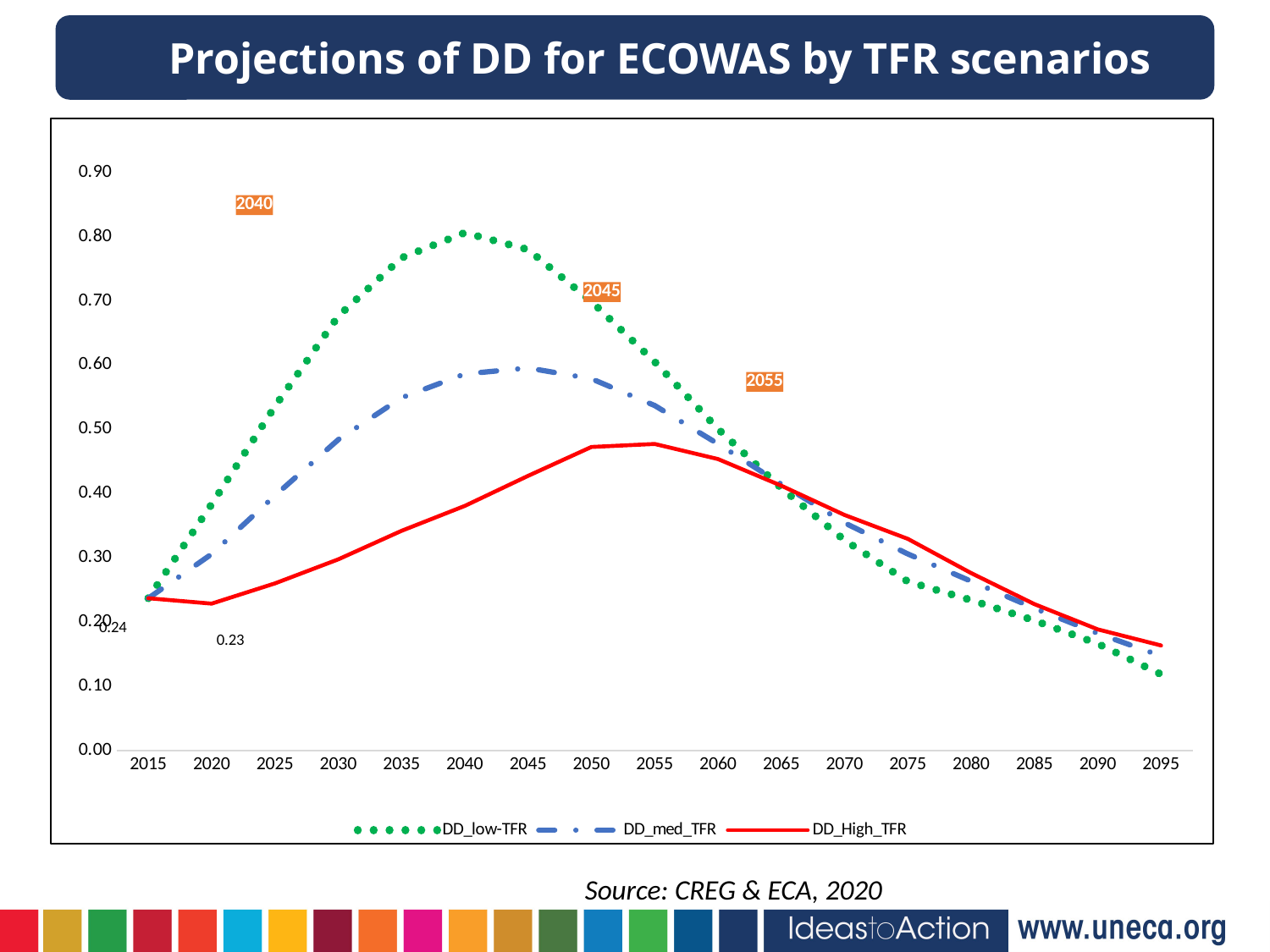
How many years are marked along the x axis? 17 Is the value for DD_High_TFR in 2055 greater or less than 0.50? less What value is labelled on the chart at 2015? 0.24 What is the value of DD_High_TFR in 2020? 0.23 Which series reaches the highest peak value? DD_low-TFR In 2040, which series has the higher value, DD_low-TFR or DD_High_TFR? DD_low-TFR How many series does the legend list? 3 What is the title of the chart? Projections of DD for ECOWAS by TFR scenarios Is the value for DD_med_TFR in 2045 greater or less than 0.50? greater Is the value for DD_low-TFR in 2040 greater or less than 0.70? greater Does the DD_low-TFR series rise or fall between 2040 and 2095? fall What kind of chart is shown on the slide? line chart